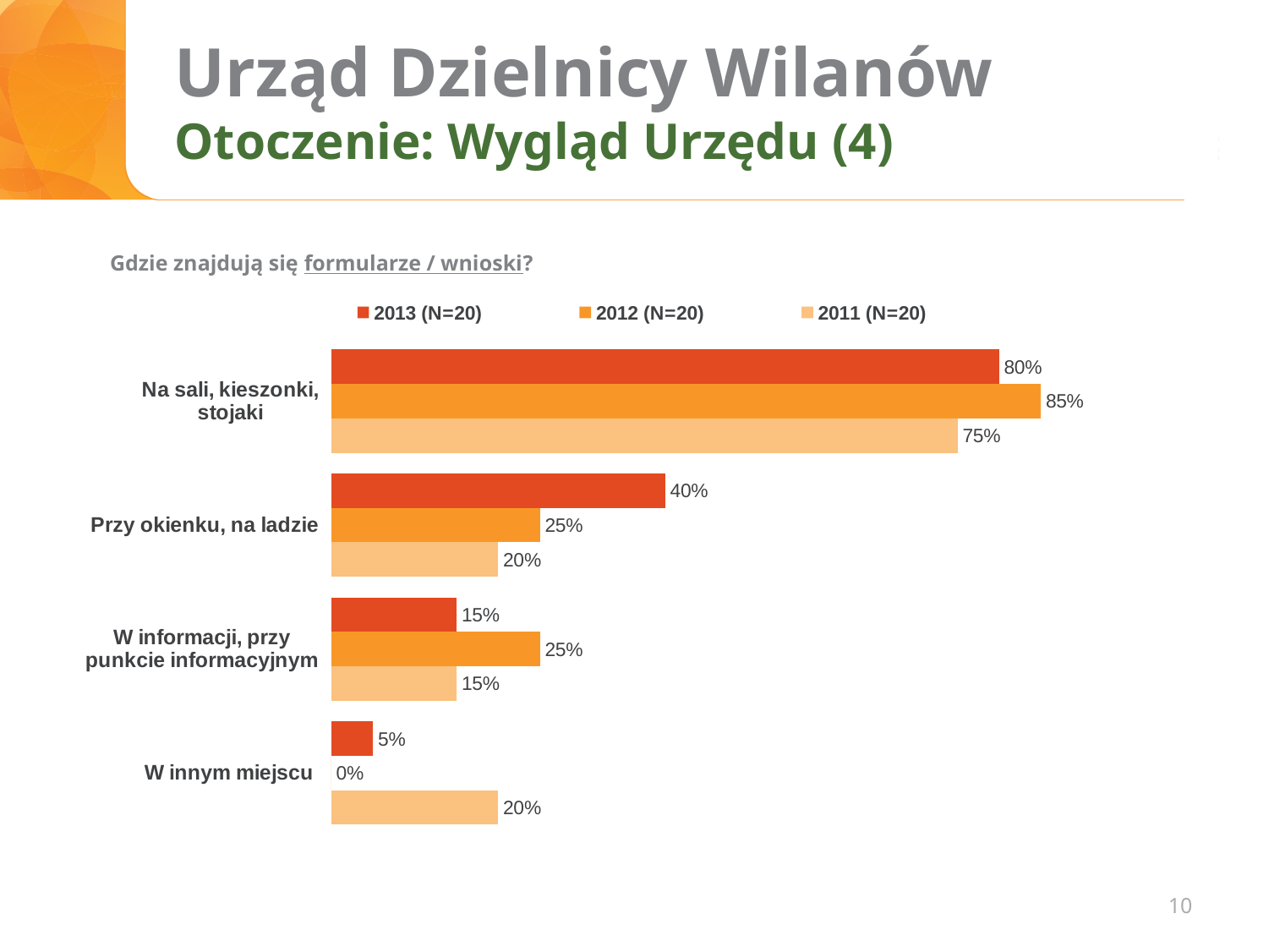
What is the value for "W innym miejscu" in the 2012 (N=20) series? 0% What kind of chart is shown on the slide? Bar chart Which category has the highest value in the 2012 (N=20) series? Na sali, kieszonki, stojaki Which is larger for "Przy okienku, na ladzie": the 2013 (N=20) value or the 2012 (N=20) value? 2013 (N=20) Which category has the lowest value in the 2013 (N=20) series? W innym miejscu What is the value for "W informacji, przy punkcie informacyjnym" in the 2012 (N=20) series? 25% What question does the chart answer, according to the text above it? Gdzie znajdują się formularze / wnioski? How many series does the legend list? 3 What is the value for "Na sali, kieszonki, stojaki" in the 2013 (N=20) series? 80% How many categories are shown on the chart? 4 What is the difference between the 2012 (N=20) and 2011 (N=20) values for "Na sali, kieszonki, stojaki"? 10% What is the value for "Przy okienku, na ladzie" in the 2011 (N=20) series? 20%